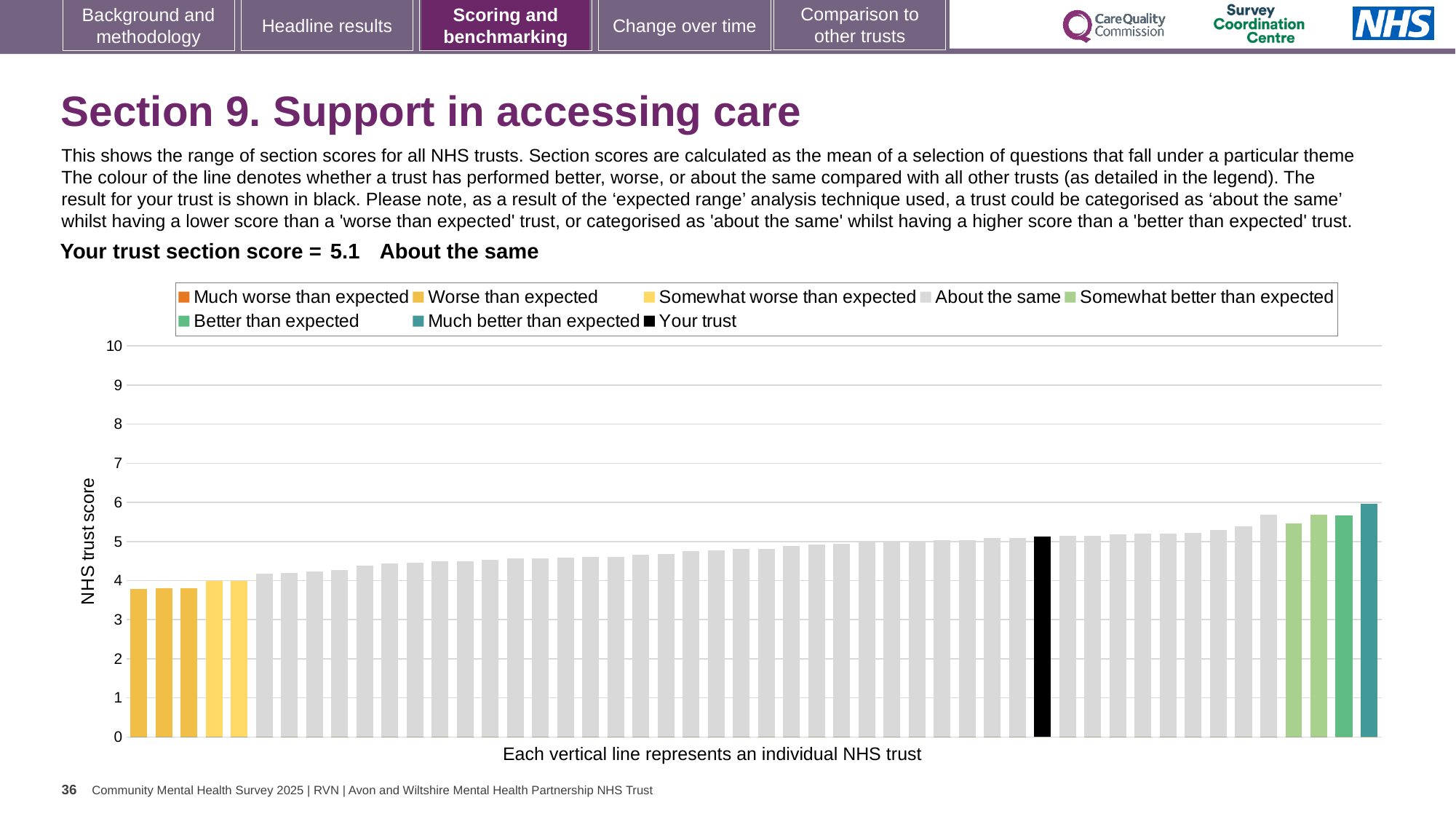
Which legend category do the lowest bars belong to? Worse than expected Which legend category does the tallest bar belong to? Much better than expected Do the bar values rise or fall from left to right along the x axis? rise Is the value of the tallest bar greater or less than 5? greater How many entries does the chart legend list? 8 What is the section score for your trust shown on the slide? 5.1 What kind of chart is shown on the slide? bar chart Is the value of the lowest bar greater or less than 3? greater Is the value of the lowest bar greater or less than 4? less What is the label on the vertical axis of the chart? NHS trust score What colour is the bar representing your trust? black